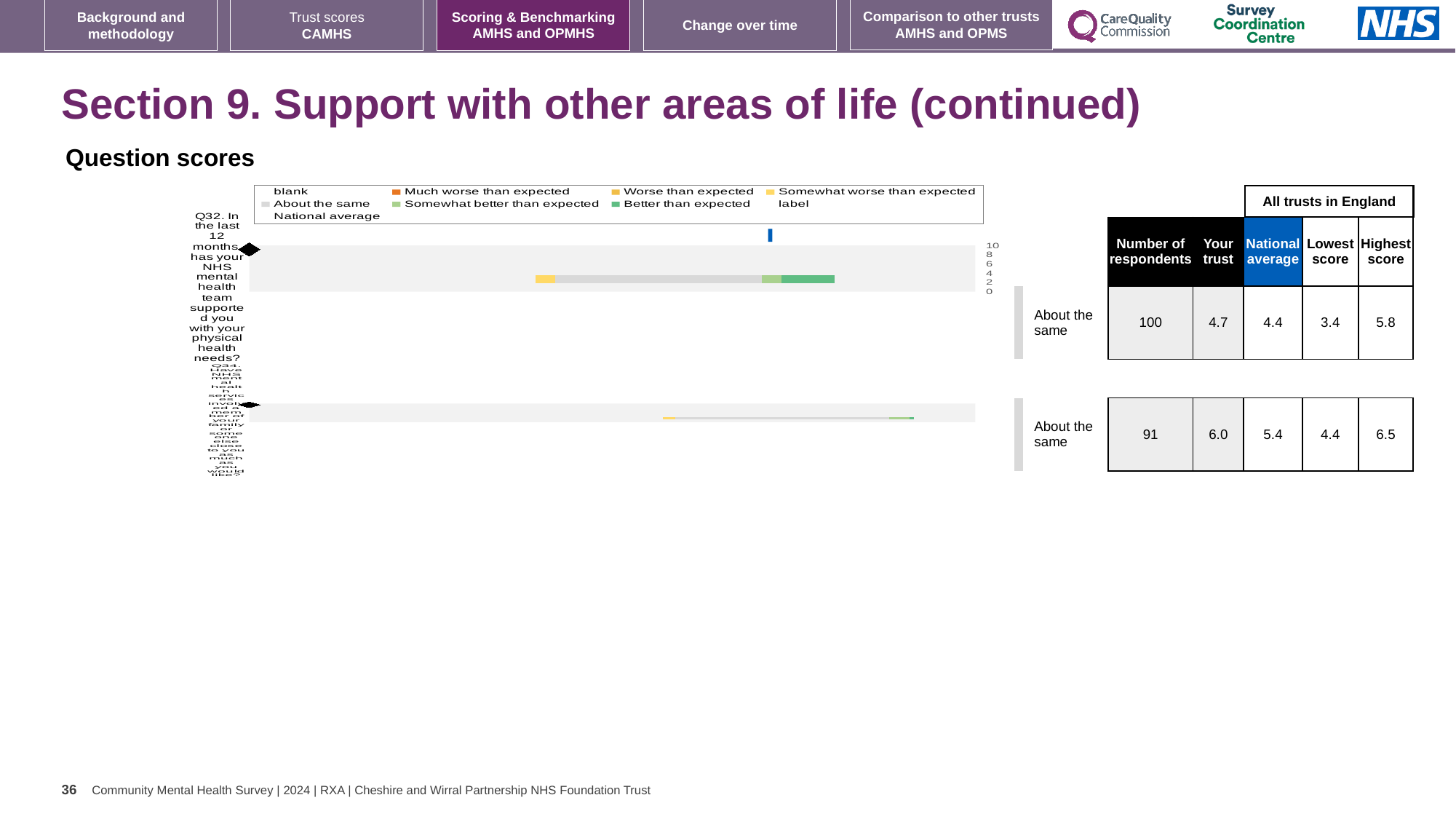
How many survey questions are plotted in the chart? 2 What benchmark category is shown next to the Q32 bar? About the same What is the difference between the 'Your trust' score and the national average for Q32? 0.3 For Q32, which is larger: the 'Your trust' score or the national average? Your trust What is the 'Your trust' score for Q32 (support with physical health needs)? 4.7 What is the maximum value shown on the chart's score axis? 10 What is the difference between the highest score and the lowest score for Q34? 2.1 What kind of chart is shown on the slide? Bar chart What is the national average score for Q32? 4.4 What is the highest score among all trusts in England for Q34? 6.5 Which question had more respondents, Q32 or Q34? Q32 How many respondents answered Q34 (involving family or someone close)? 91